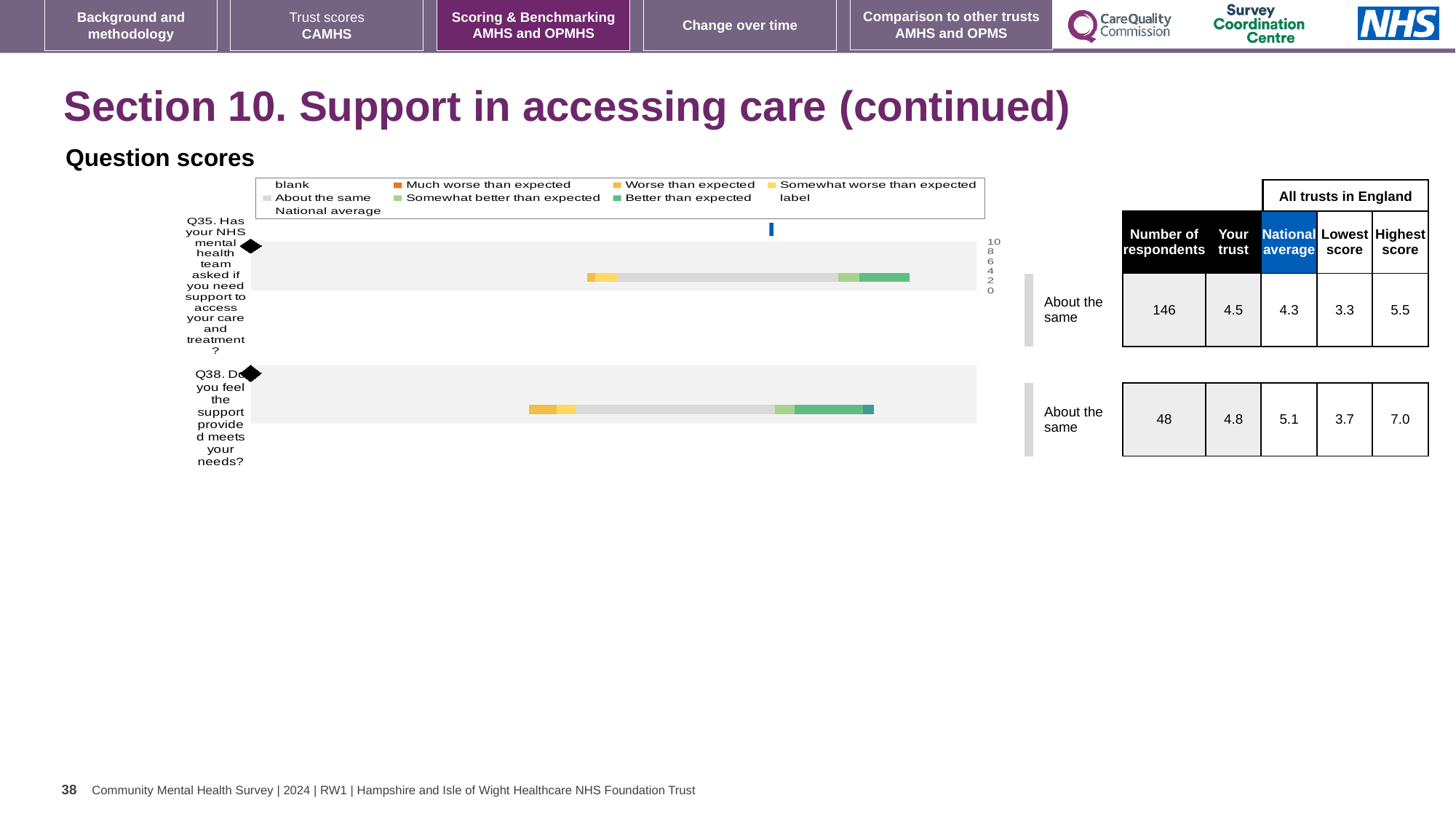
Which question has the higher 'Your trust' score in the table beside the chart, Q35 or Q38? Q38 Which legend entry is shown in grey in the chart? About the same According to the table beside the chart, what is the 'Your trust' score for Q38? 4.8 What is the difference between the 'Your trust' scores for Q38 and Q35 in the table beside the chart? 0.3 According to the table beside the chart, what is the 'Your trust' score for Q35? 4.5 How many entries does the chart legend list? 9 How many questions (bars) are plotted in the chart? 2 What is the highest score across all trusts in England for Q38, as shown in the table beside the chart? 7.0 According to the table beside the chart, what is the national average for Q38? 5.1 According to the table beside the chart, how many respondents answered Q35? 146 What is the highest tick value shown on the chart's axis? 10 What kind of chart is shown under 'Question scores'? bar chart